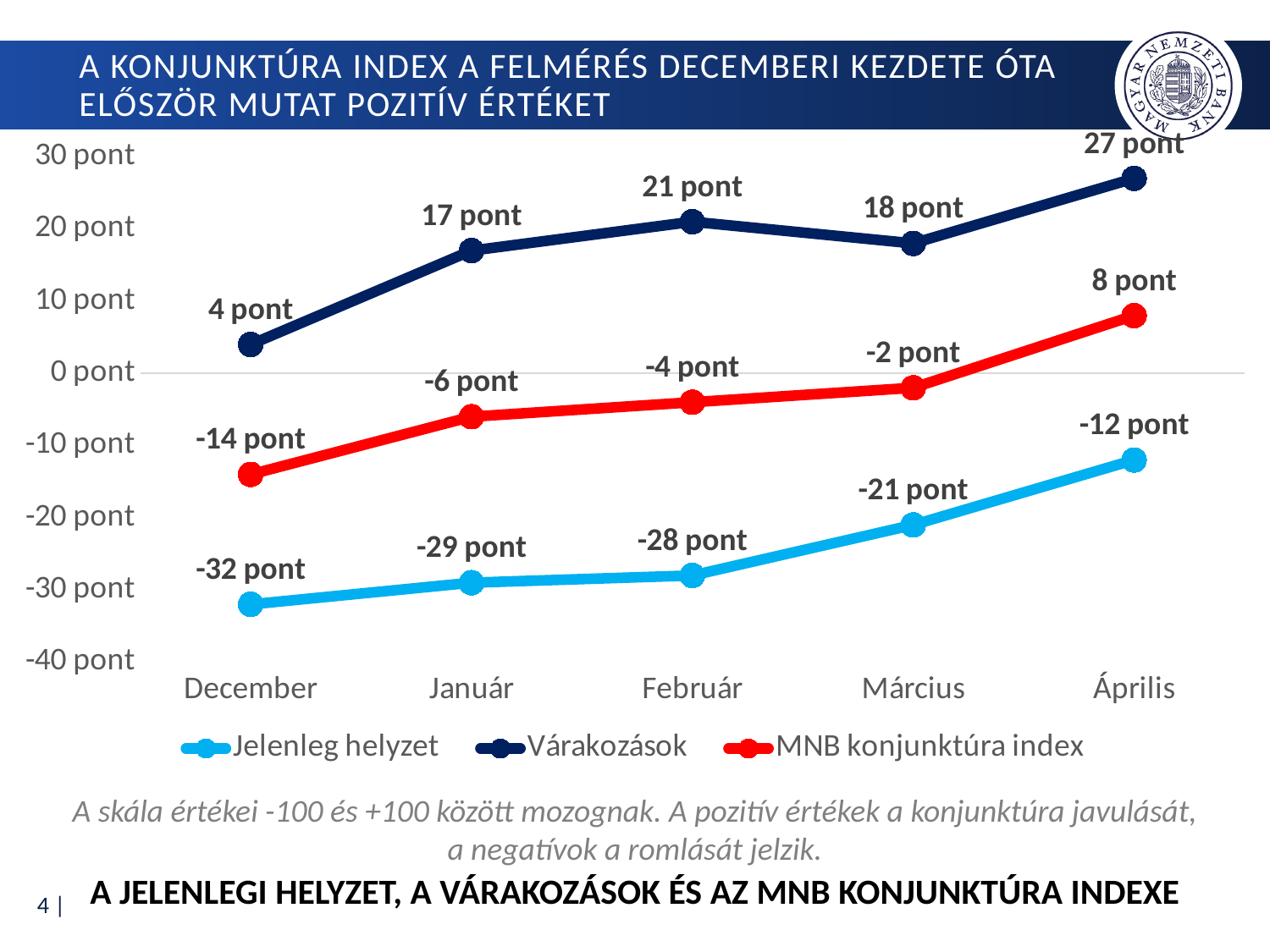
What is the value of Jelenleg helyzet in December? -32 pont Does the MNB konjunktúra index rise or fall from December to Április? Rise What kind of chart is shown on the slide? Line chart What is the value of Várakozások in Február? 21 pont Which colour is used for the Várakozások series? Dark blue What is the difference between the Várakozások value and the Jelenleg helyzet value in Március? 39 pont Which is larger in Január: the MNB konjunktúra index or the Jelenleg helyzet value? MNB konjunktúra index In which month is the Várakozások series highest? Április How many series does the legend list? 3 How many months are shown on the x axis? 5 In which month is the Jelenleg helyzet series lowest? December What is the value of the MNB konjunktúra index in Április? 8 pont